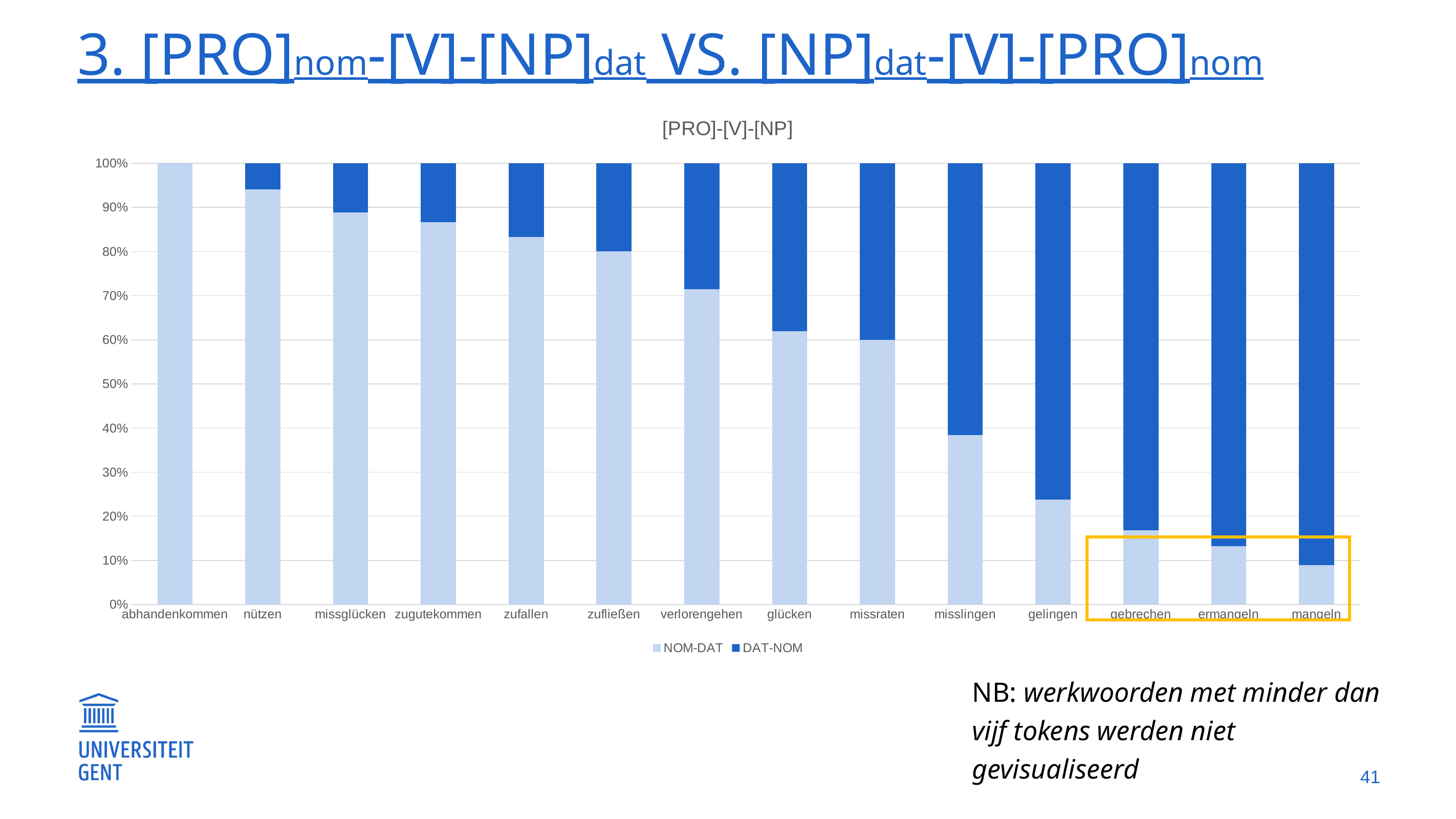
Which has the larger NOM-DAT share, glücken or misslingen? glücken How many series does the legend list? 2 Which verb has the highest NOM-DAT share? abhandenkommen What are the two series named in the legend? NOM-DAT and DAT-NOM Which verb has the highest DAT-NOM share? mangeln What kind of chart is shown on the slide? stacked bar chart What is the title of the chart? [PRO]-[V]-[NP] What is the NOM-DAT share for abhandenkommen? 100% Is the NOM-DAT share for gelingen greater or less than 30%? less How many verbs (categories) are plotted on the x axis? 14 Is the NOM-DAT share for nützen greater or less than 90%? greater Which verb has the lowest NOM-DAT share? mangeln